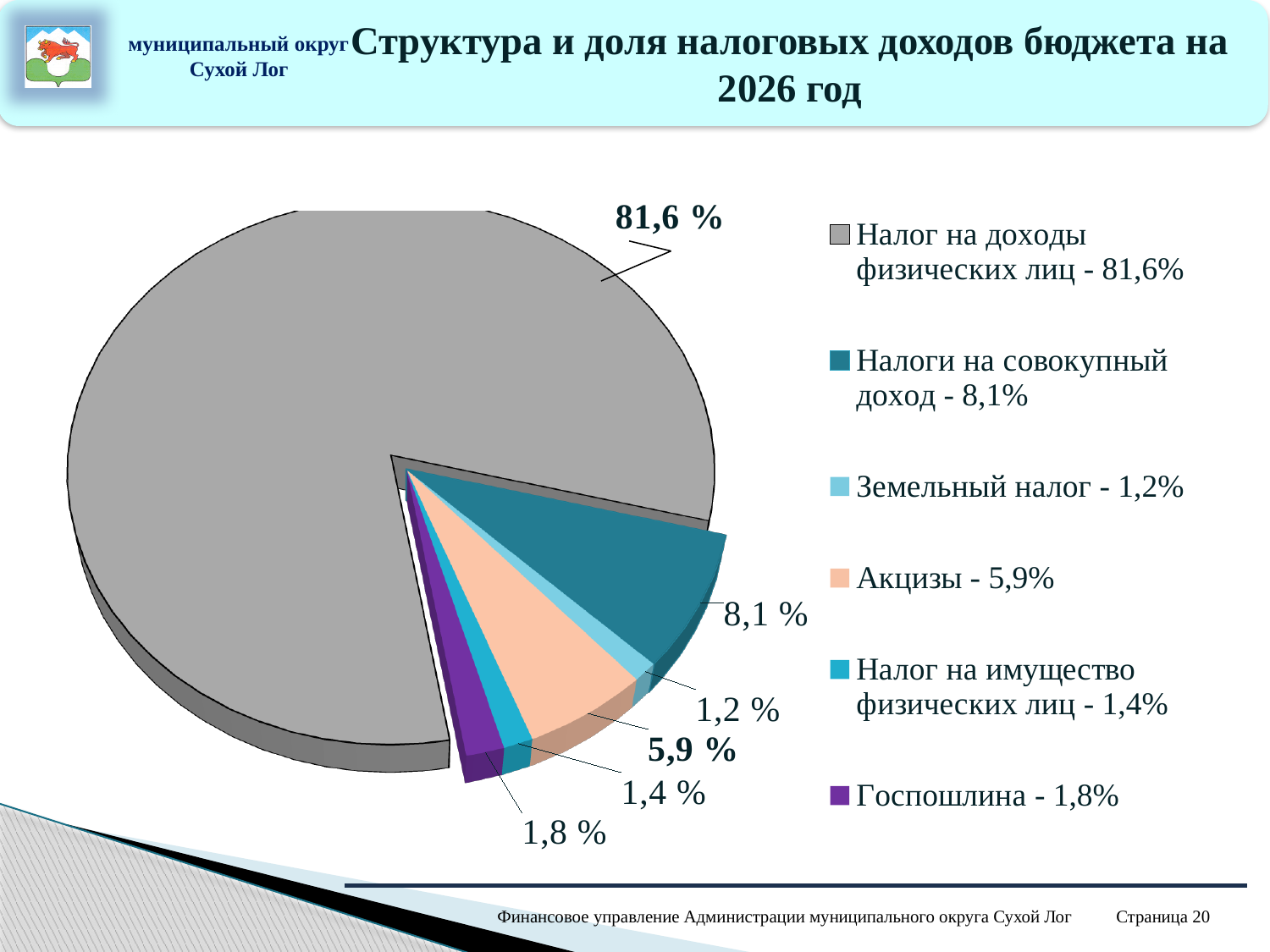
What is the value for "Земельный налог"? 1,2 % Which category has the smallest slice of the pie? Земельный налог What is the title of the slide containing the chart? Структура и доля налоговых доходов бюджета на 2026 год Which category has the largest slice of the pie? Налог на доходы физических лиц What share of the pie does "Налог на доходы физических лиц" have? 81,6 % How many slices does the pie chart have? 6 What kind of chart is shown on the slide? pie chart What is the value for "Налоги на совокупный доход"? 8,1 % What is the difference between the values for "Налоги на совокупный доход" and "Акцизы"? 2,2 % What is the value for "Акцизы"? 5,9 % Which is larger: "Госпошлина" or "Налог на имущество физических лиц"? Госпошлина What is the value for "Госпошлина"? 1,8 %